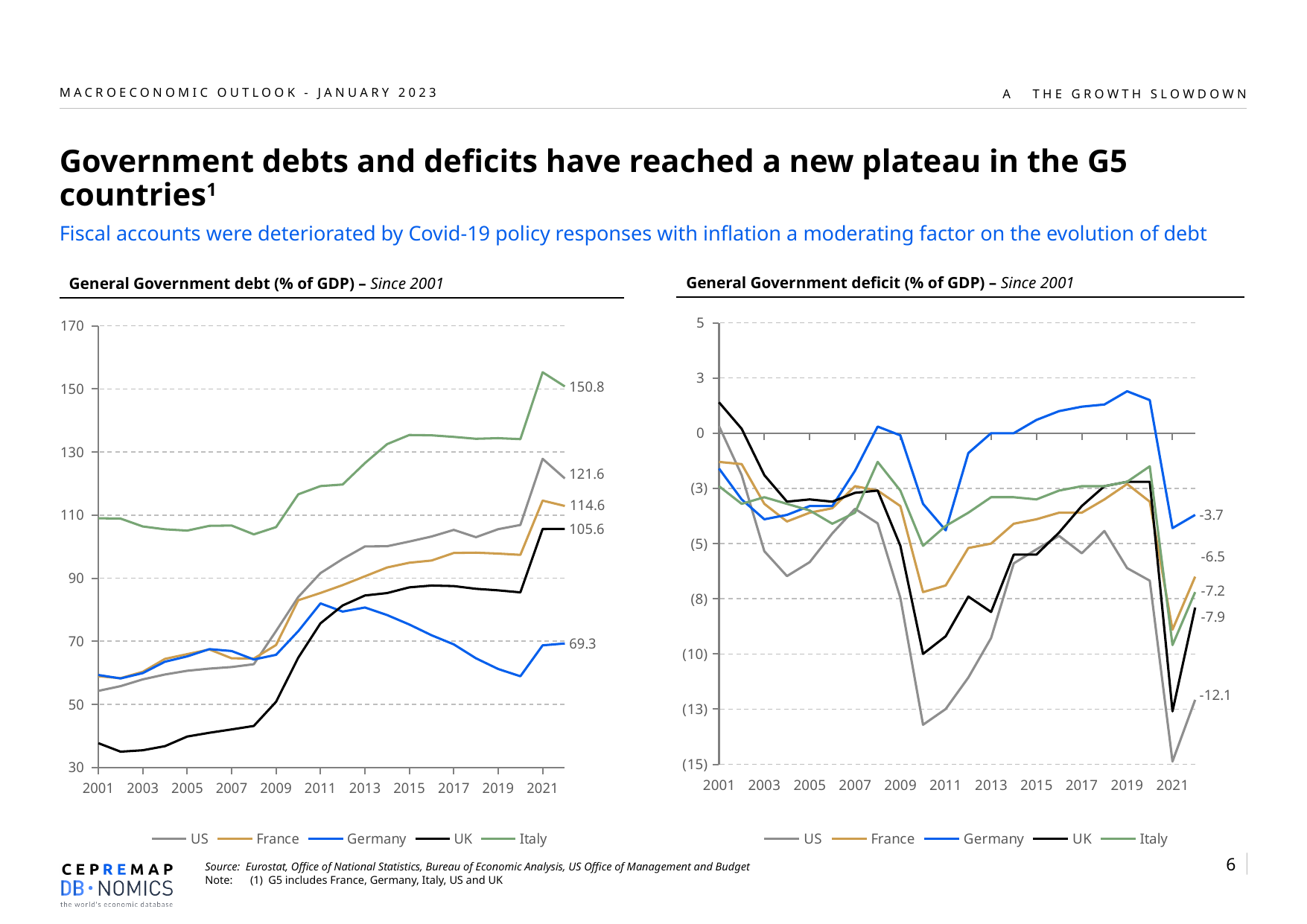
On the General Government deficit chart, is the value for the US in 2010 greater or less than -10? less On the General Government deficit chart, what is the final labelled value for Germany? -3.7 On the General Government debt chart, which country has the highest debt at the end of the series? Italy What kind of chart is the General Government debt chart? Line chart On the General Government deficit chart, what is the final labelled value for the US? -12.1 On the General Government debt chart, is the value for the UK in 2001 greater or less than 50? less On the General Government debt chart, what is the final labelled value for Italy? 150.8 How many series does the legend of the General Government deficit chart list? 5 On the General Government debt chart, which country has the lowest debt at the end of the series? Germany On the General Government debt chart, what is the difference between the final labelled values for the US and France? 7.0 On the General Government debt chart, what is the final labelled value for Germany? 69.3 On the General Government debt chart, what is the final labelled value for the UK? 105.6